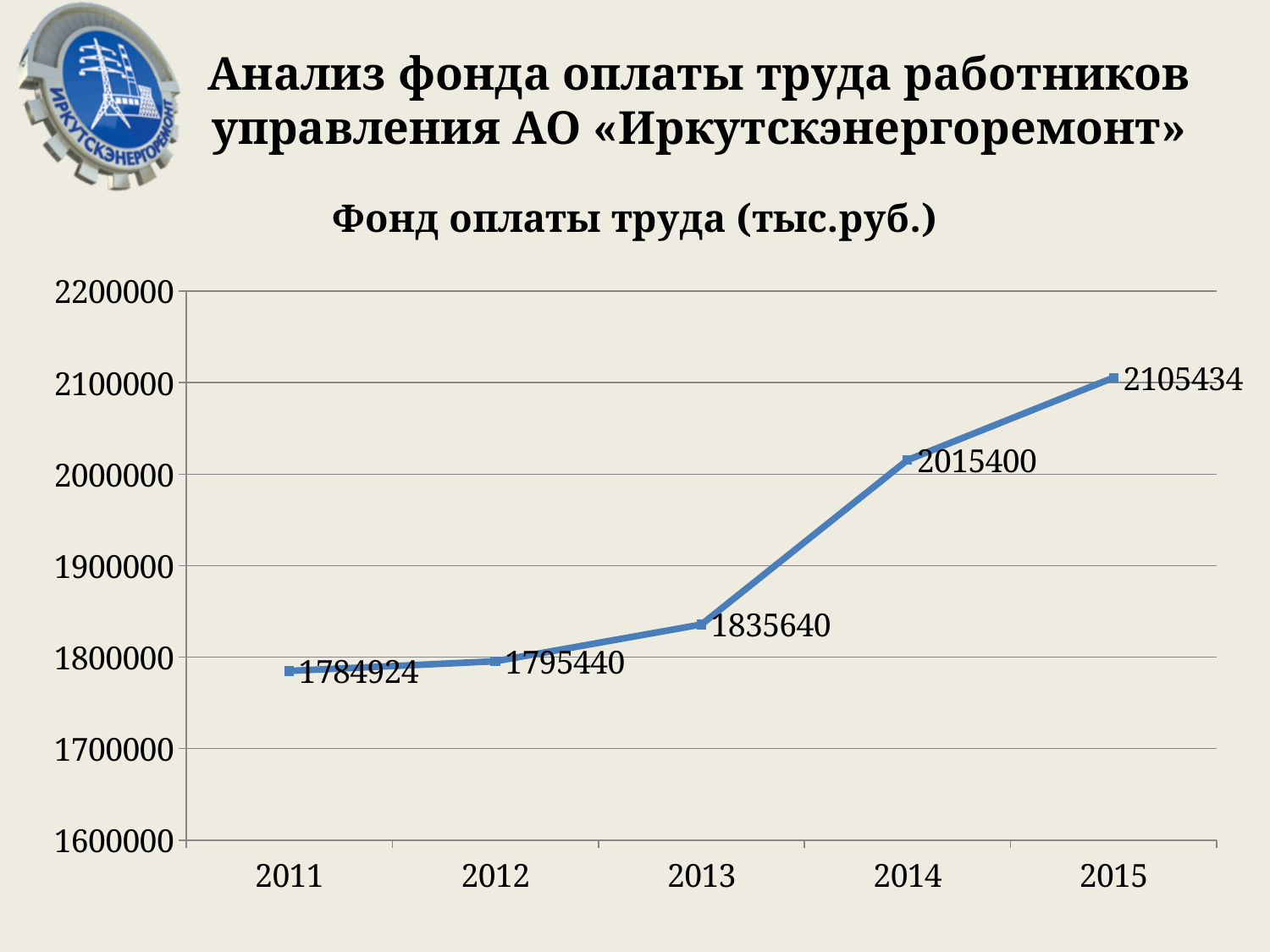
Which year has the lowest value in the chart? 2011 Do the values rise or fall from 2011 to 2015? rise Is the value for 2014 greater or less than 2000000? greater What is the difference between the values for 2015 and 2014? 90034 What is the value for 2015 in the chart? 2105434 What is the value for 2011 in the chart? 1784924 What is the value for 2013 in the chart? 1835640 Which is larger, the value for 2012 or the value for 2014? 2014 Which year has the highest value in the chart? 2015 How many years are plotted in the chart? 5 What is the difference between the values for 2014 and 2013? 179760 What kind of chart is shown on the slide? line chart